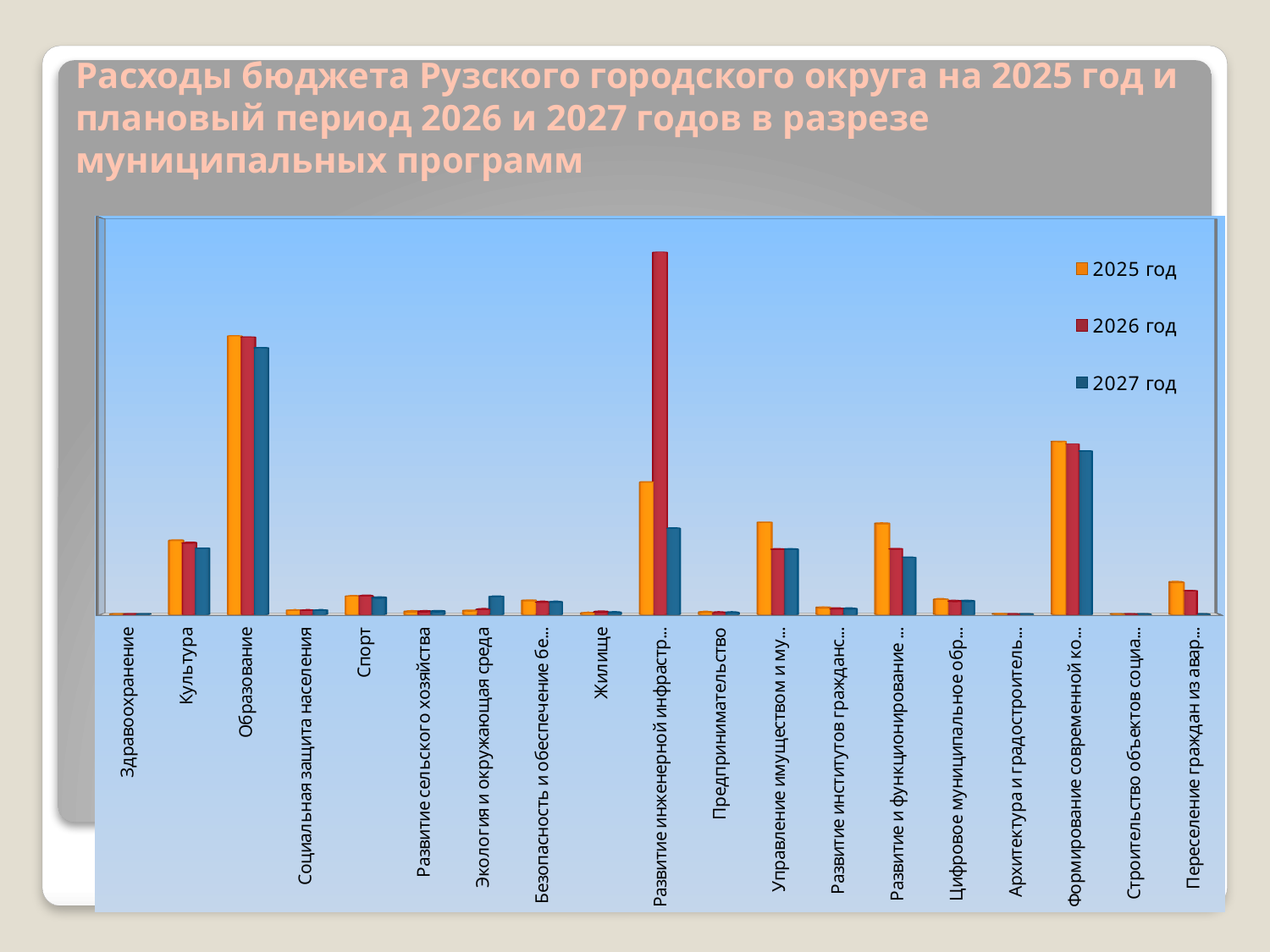
Which is larger for 2025 год: Культура or Спорт? Культура Which is larger for 2025 год: Образование or Формирование современной ко...? Образование What are the three entries in the chart legend? 2025 год, 2026 год, 2027 год Which category has the highest value for the 2025 год series? Образование How many series does the legend list? 3 Which category has the highest value for the 2027 год series? Образование Which colour represents the 2027 год series? Blue How many categories are shown along the x axis? 19 What kind of chart is shown on the slide? Bar chart Which category has the highest value for the 2026 год series? Развитие инженерной инфрастр... For the category Развитие инженерной инфрастр..., which series has the tallest bar? 2026 год